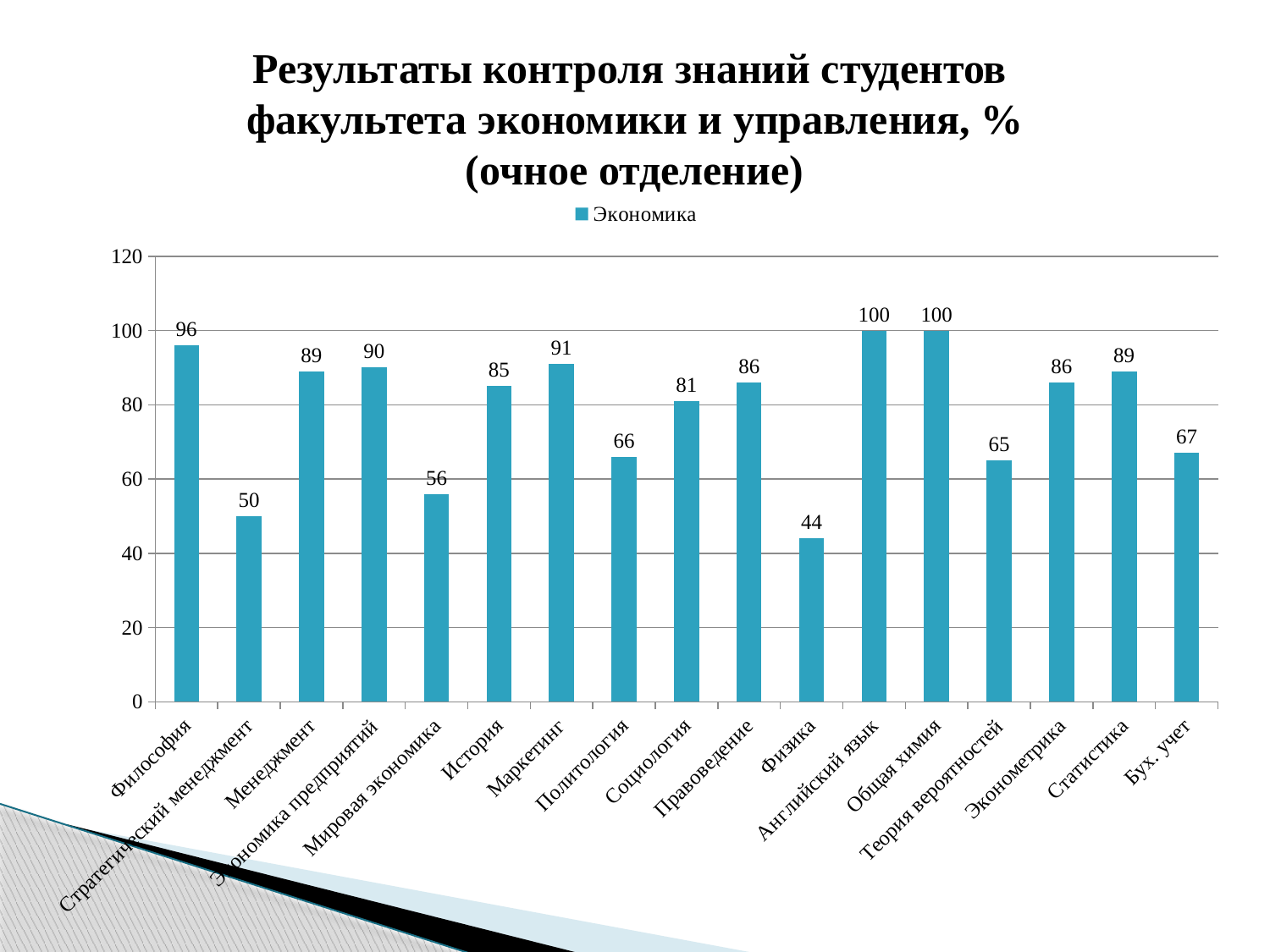
What is the difference between the values for Общая химия and Бух. учет? 33 Which is larger, the value for Мировая экономика or the value for История? История What is the value for Теория вероятностей? 65 What is the difference between the values for Философия and Стратегический менеджмент? 46 What is the value for Физика? 44 How many categories are shown on the x axis? 17 Which is larger, the value for Политология or the value for Социология? Социология What is the name of the series shown in the legend? Экономика What is the value for Маркетинг? 91 What kind of chart is shown on the slide? Bar chart How many series does the legend list? 1 Which category has the lowest value? Физика